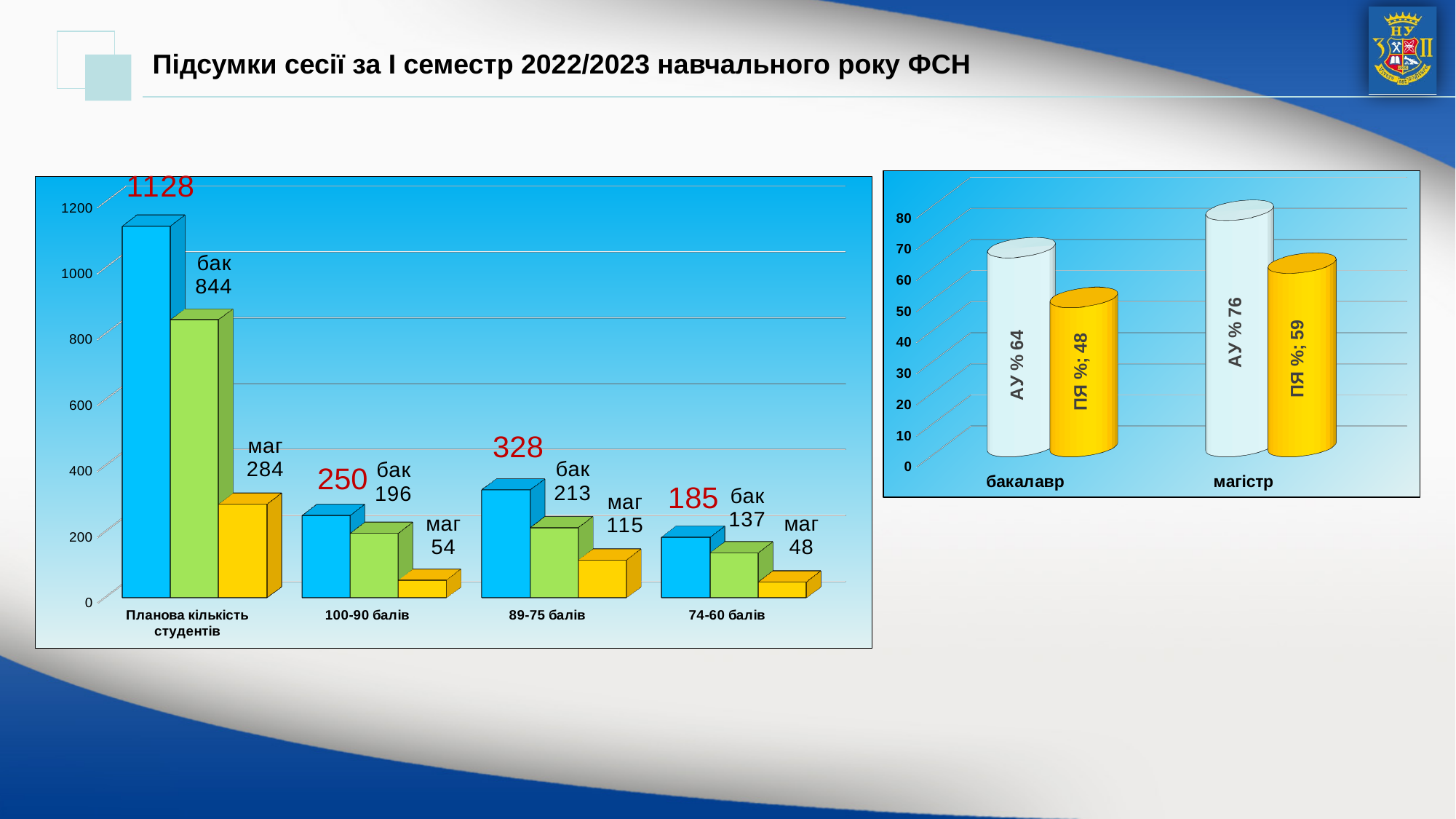
In the right chart, what is the difference between the 'АУ %' values for 'магістр' and 'бакалавр'? 12 In the left chart, what is the value of the red-labelled total bar for the category 'Планова кількість студентів'? 1128 In the left chart, which category has the lowest red-labelled total value? 74-60 балів In the left chart, what is the 'бак' value for the category '89-75 балів'? 213 In the left chart, what is the difference between the 'бак' and 'маг' values for the category '74-60 балів'? 89 How many categories are shown on the x axis of the left chart? 4 In the right chart, what is the 'АУ %' value for 'магістр'? 76 What kind of chart is the left chart? bar chart In the left chart, what is the 'маг' value for the category '100-90 балів'? 54 In the right chart, what is the 'ПЯ %' value for 'бакалавр'? 48 In the left chart, which is larger: the 'маг' value for '89-75 балів' or the 'маг' value for '100-90 балів'? 89-75 балів In the right chart, which category has the higher 'ПЯ %' value? магістр